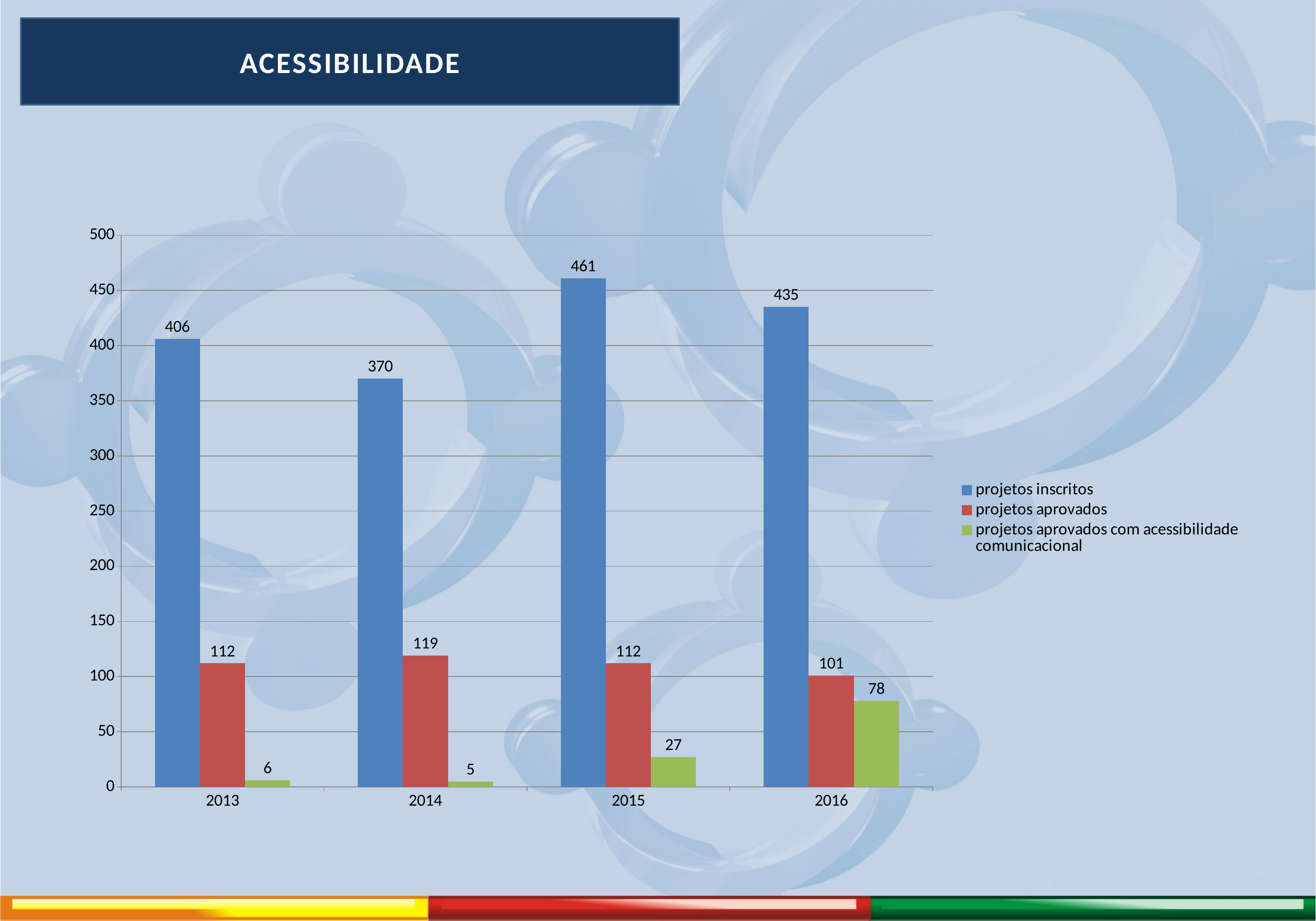
What is the value for projetos inscritos in 2015? 461 Which year has the highest value for projetos inscritos? 2015 What kind of chart is shown on the slide? bar chart What is the value for projetos aprovados in 2014? 119 What is the value for projetos aprovados com acessibilidade comunicacional in 2016? 78 Do the values for projetos aprovados com acessibilidade comunicacional rise or fall from 2014 to 2016? rise Which year has the lowest value for projetos aprovados com acessibilidade comunicacional? 2014 Is the value for projetos inscritos in 2016 greater or less than 400? greater How many series does the legend list? 3 What is the difference between projetos inscritos in 2015 and in 2014? 91 How many years are shown on the x axis? 4 Which is larger: projetos aprovados in 2013 or in 2016? 2013